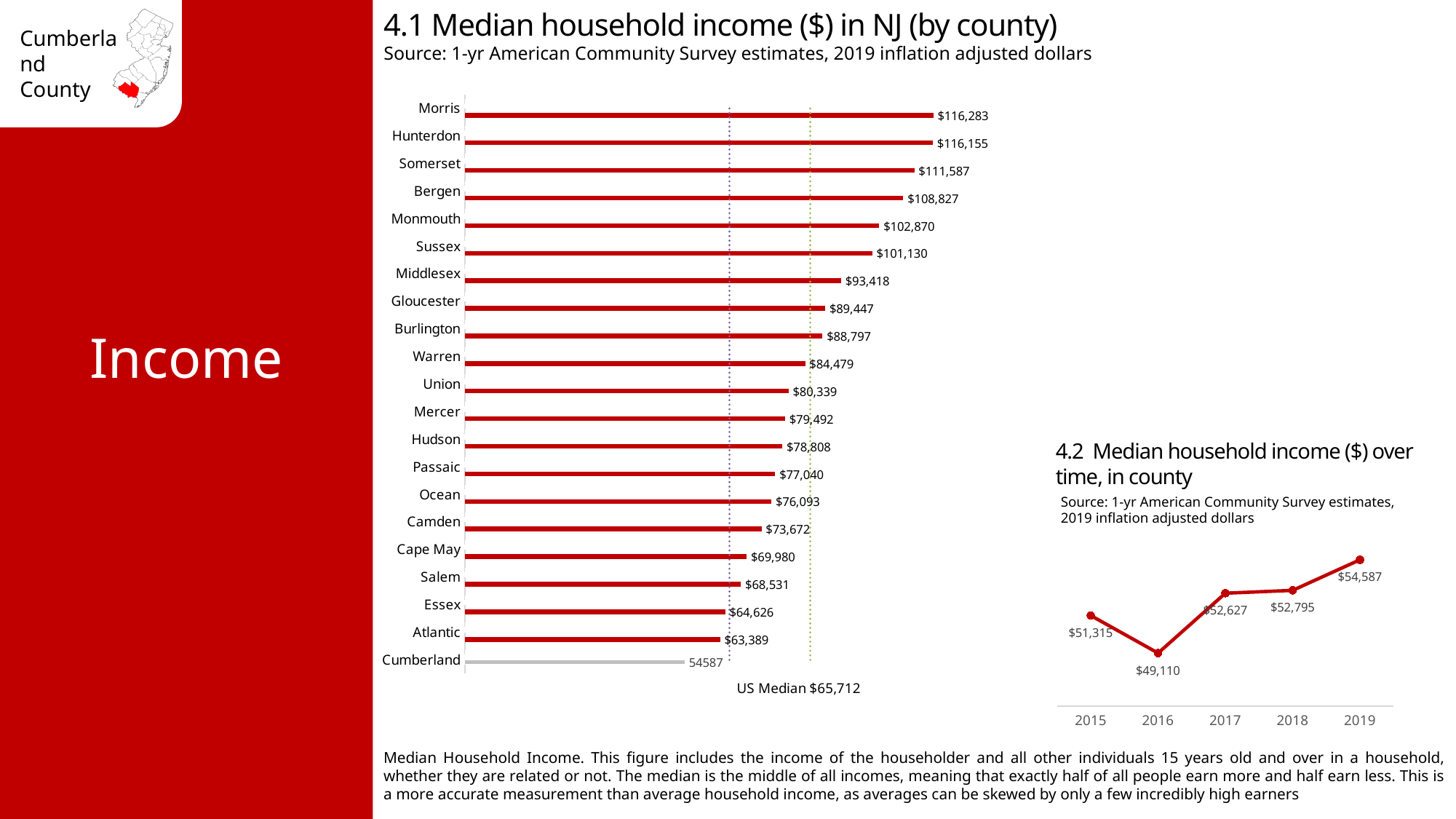
In chart 4.2, what is the difference between the median household income in 2019 and 2016? $5,477 In chart 4.1, which county has a higher median household income, Middlesex or Union? Middlesex In chart 4.2, which year has the highest median household income? 2019 How many counties are shown in chart 4.1? 21 In chart 4.2, what was the median household income in 2016? $49,110 In chart 4.1, what is the difference between the median household income of Morris and Cumberland? $61,696 In chart 4.1, what US Median value is labelled on the chart? $65,712 In chart 4.1, what is the median household income for Cumberland county? 54587 In chart 4.1, which county has the lowest median household income? Cumberland What kind of chart is chart 4.1? Bar chart What kind of chart is chart 4.2? Line chart In chart 4.1, what is the median household income for Bergen county? $108,827